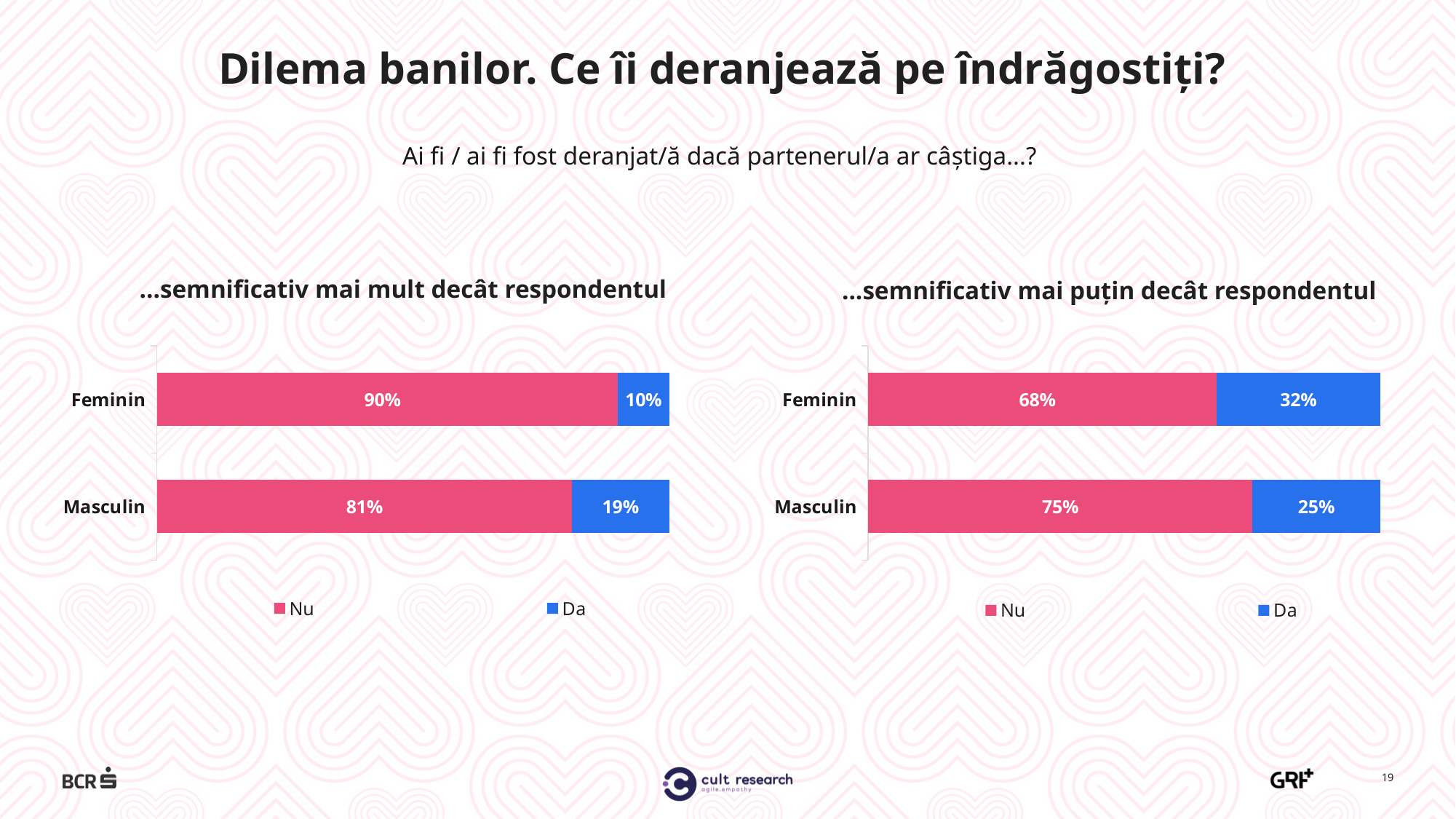
In the left chart ('...semnificativ mai mult decât respondentul'), which category has the higher 'Da' value? Masculin In the right chart ('...semnificativ mai puțin decât respondentul'), which category has the lower 'Nu' value? Feminin In the left chart ('...semnificativ mai mult decât respondentul'), what is the 'Nu' value for Feminin? 90% What kind of chart is the right chart ('...semnificativ mai puțin decât respondentul')? Stacked bar chart Is the 'Da' value for Feminin larger in the left chart or in the right chart? Right chart In the left chart ('...semnificativ mai mult decât respondentul'), what is the difference between the 'Nu' values for Feminin and Masculin? 9% In the left chart ('...semnificativ mai mult decât respondentul'), what is the 'Da' value for Masculin? 19% What is the total of the stacked bar for Masculin in the right chart ('...semnificativ mai puțin decât respondentul')? 100% In the right chart ('...semnificativ mai puțin decât respondentul'), what is the 'Nu' value for Masculin? 75% How many series does the legend of the left chart list? 2 In the right chart ('...semnificativ mai puțin decât respondentul'), what is the 'Da' value for Feminin? 32% In the right chart ('...semnificativ mai puțin decât respondentul'), what is the difference between the 'Da' values for Feminin and Masculin? 7%